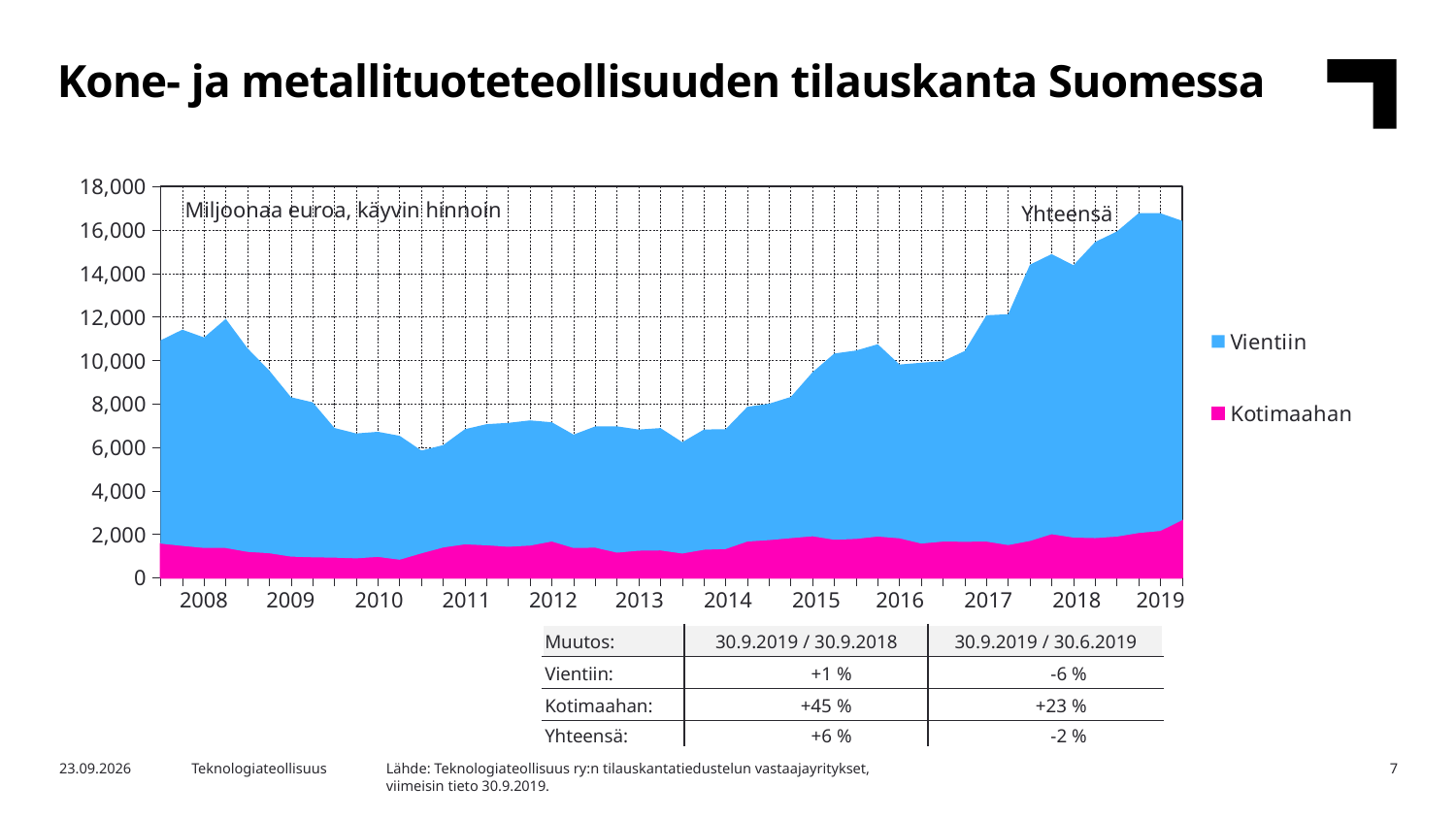
Which is larger in 2019, the Vientiin series or the Kotimaahan series? Vientiin Is the total (Yhteensä) value at the start of 2008 greater or less than 10,000? greater Is the Kotimaahan value in 2010 greater or less than 2,000? less Is the total (Yhteensä) value at the end of 2019 greater or less than 16,000? greater Which two series are listed in the chart legend? Vientiin and Kotimaahan What is the title of the chart on the slide? Kone- ja metallituoteteollisuuden tilauskanta Suomessa What kind of chart is shown on the slide? Stacked area chart How many series does the chart legend list? 2 How many years are labelled on the x axis of the chart? 12 Does the total order backlog rise or fall between 2016 and 2019? rise